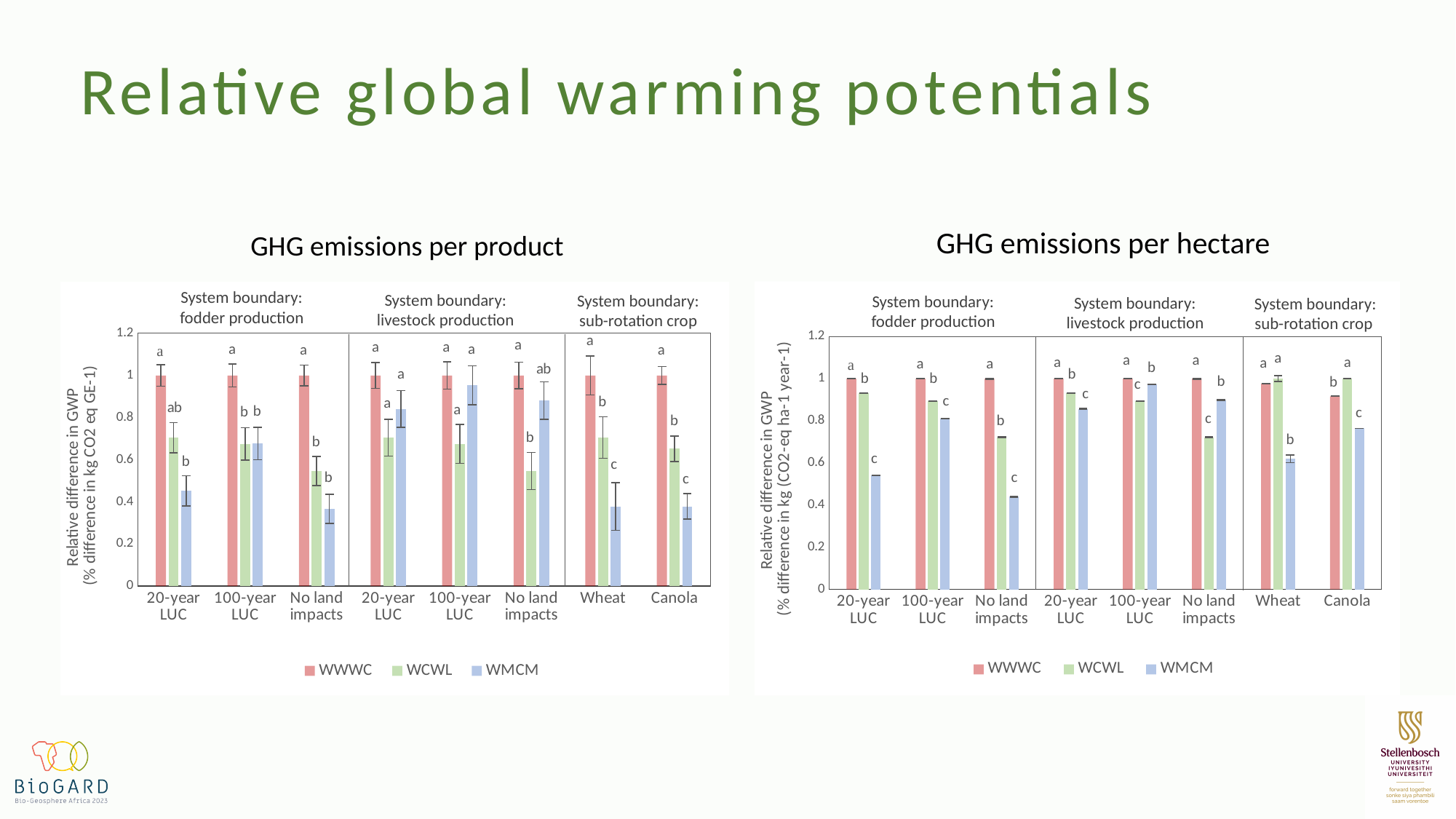
Which series is shown in blue in the 'GHG emissions per product' chart? WMCM How many series does the legend of the 'GHG emissions per hectare' chart list? 3 In the 'GHG emissions per hectare' chart, is the value of WMCM for Canola greater or less than 0.6? greater In the 'GHG emissions per hectare' chart, which is larger for Wheat: WCWL or WMCM? WCWL In the 'GHG emissions per hectare' chart, is the value of WMCM for No land impacts under the fodder production system boundary greater or less than 0.6? less In the 'GHG emissions per product' chart, is the value of WCWL for Wheat greater or less than 0.6? greater In the 'GHG emissions per hectare' chart, which category has the lowest WMCM value? No land impacts (fodder production) In the 'GHG emissions per product' chart, what is the value of WWWC for 20-year LUC under the fodder production system boundary? 1 How many categories are shown along the x axis of the 'GHG emissions per product' chart? 8 What kind of chart is the 'GHG emissions per product' chart? bar chart In the 'GHG emissions per product' chart, which is larger for 20-year LUC under fodder production: WCWL or WMCM? WCWL